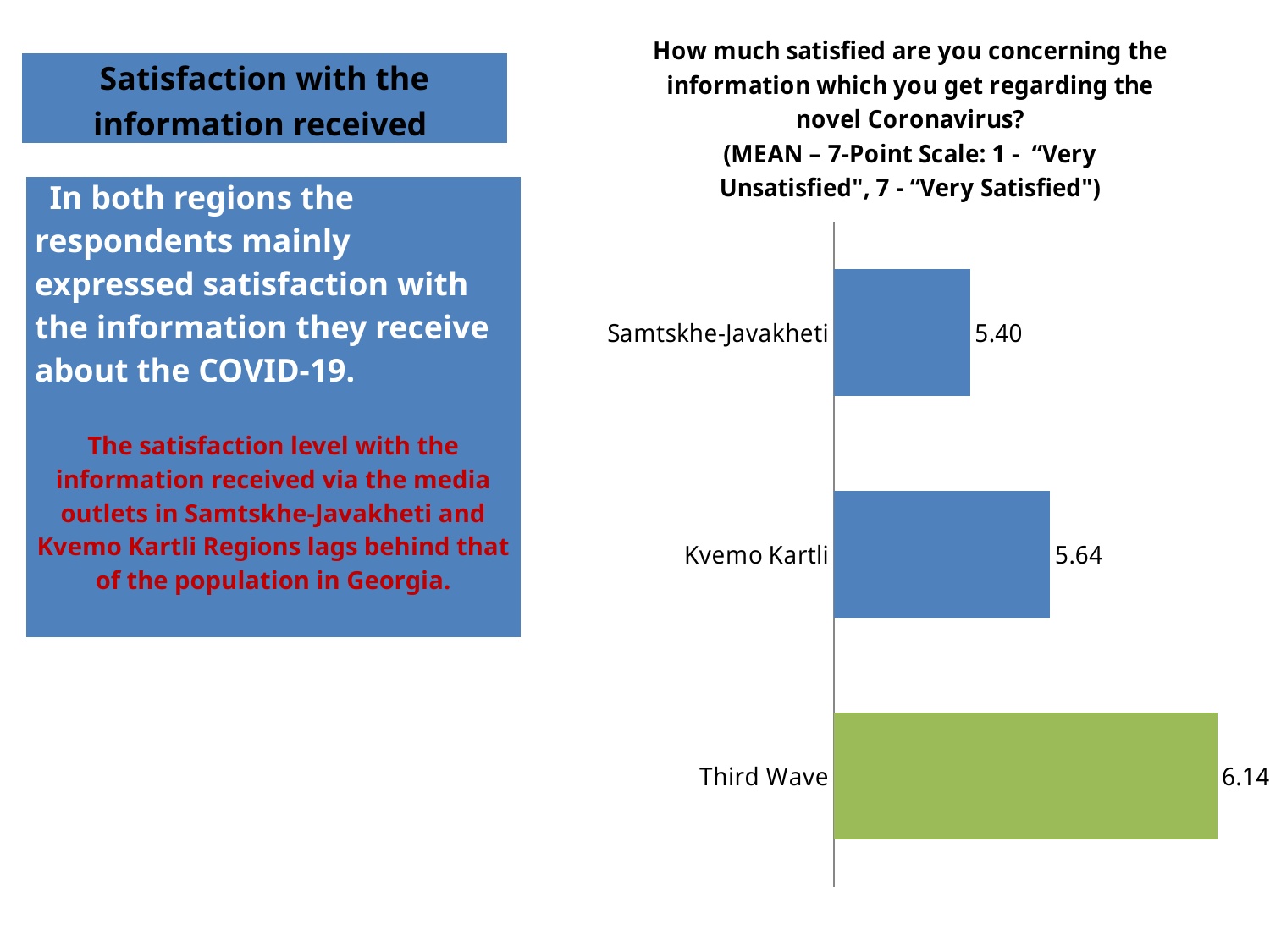
What is the value for Kvemo Kartli? 5.64 Which bar in the chart is coloured green? Third Wave What is the value for Samtskhe-Javakheti? 5.40 What is the value for Third Wave? 6.14 What scale is used for the mean values shown in the chart, according to the chart title? 7-Point Scale Which category has the highest value? Third Wave How many categories are shown in the chart? 3 Which category has the lowest value? Samtskhe-Javakheti What kind of chart is shown on the slide? Bar chart Which is larger, the value for Kvemo Kartli or the value for Samtskhe-Javakheti? Kvemo Kartli What is the difference between the values for Third Wave and Kvemo Kartli? 0.50 What is the difference between the values for Kvemo Kartli and Samtskhe-Javakheti? 0.24